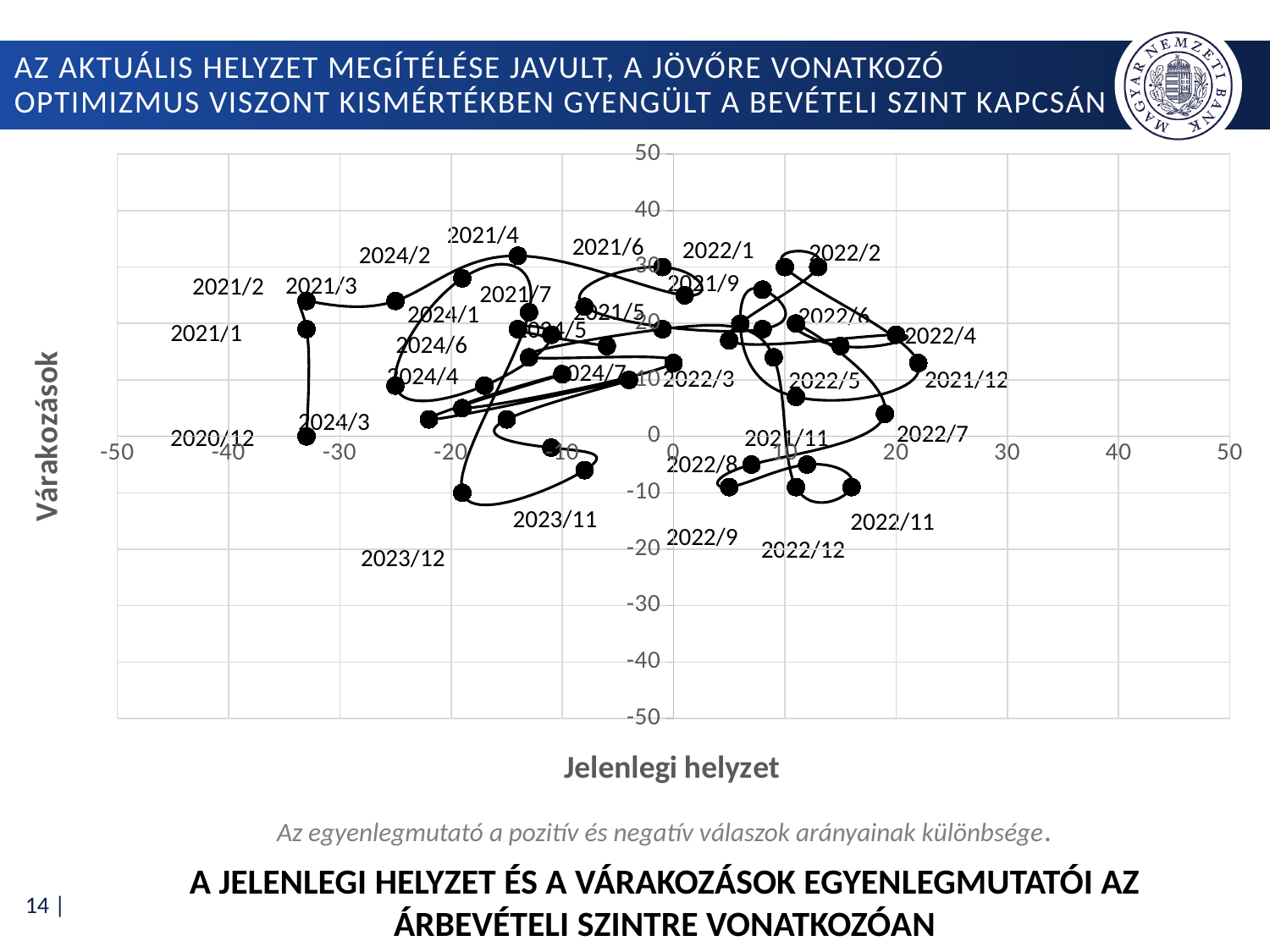
Is the vertical-axis (Várakozások) value for the point labelled 2022/11 greater or less than 0? less What is the label of the horizontal axis of the chart? Jelenlegi helyzet Is the vertical-axis (Várakozások) value for the point labelled 2022/2 greater or less than 20? greater Is the horizontal-axis (Jelenlegi helyzet) value for the point labelled 2021/12 greater or less than 10? greater What is the title of the chart? A JELENLEGI HELYZET ÉS A VÁRAKOZÁSOK EGYENLEGMUTATÓI AZ ÁRBEVÉTELI SZINTRE VONATKOZÓAN What kind of chart is shown on the slide? scatter chart